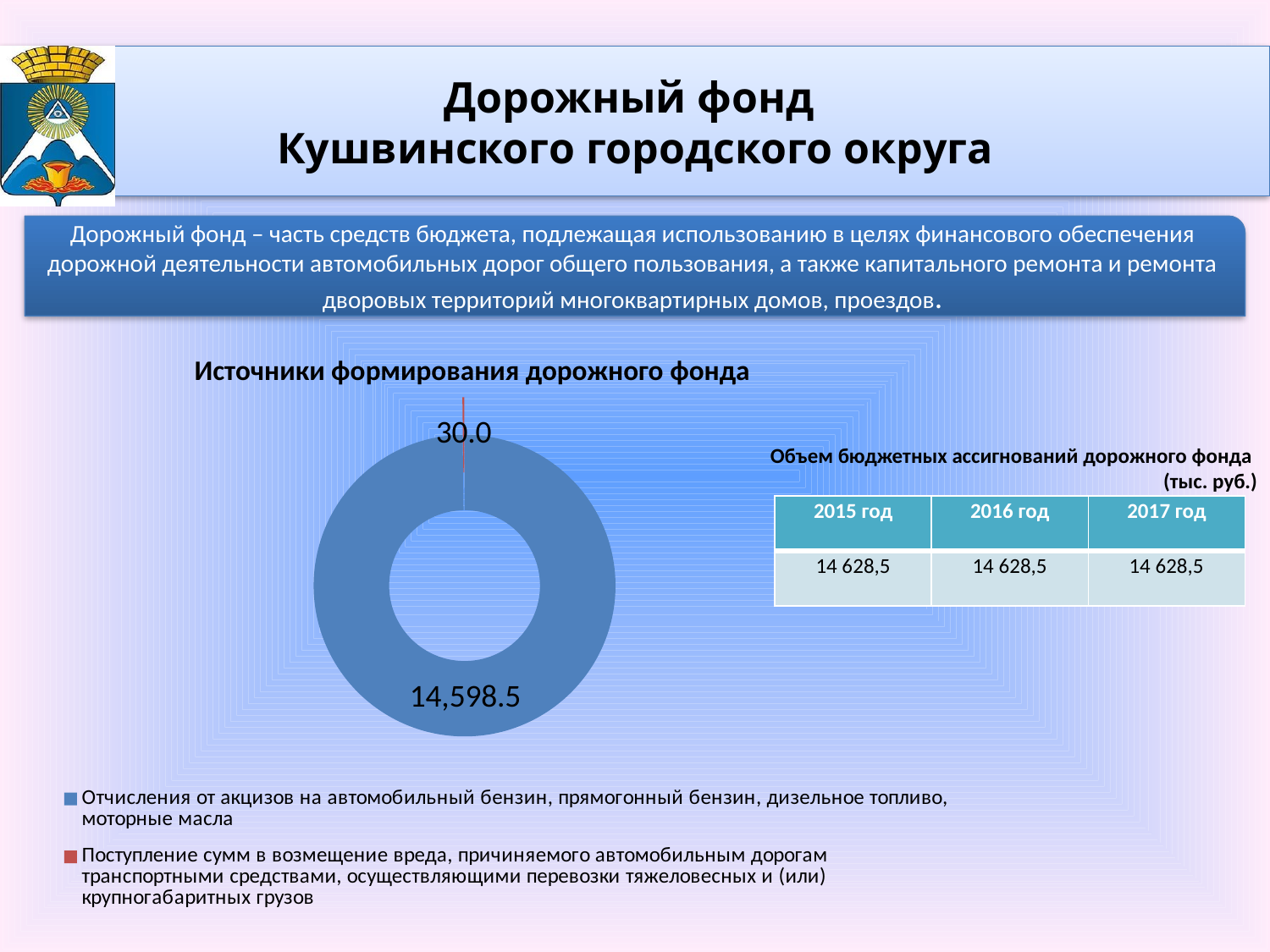
What is the difference between the two slice values in the doughnut chart (14,598.5 and 30.0)? 14,568.5 What kind of chart is shown under the title "Источники формирования дорожного фонда"? doughnut chart What is the value of the slice for "Отчисления от акцизов на автомобильный бензин, прямогонный бензин, дизельное топливо, моторные масла"? 14,598.5 What is the total of the two slice values shown in the doughnut chart? 14,628.5 What is the value of the slice for "Поступление сумм в возмещение вреда, причиняемого автомобильным дорогам транспортными средствами, осуществляющими перевозки тяжеловесных и (или) крупногабаритных грузов"? 30.0 Which is larger in the doughnut chart: the slice for excise deductions (акцизы) or the slice for damage compensation (возмещение вреда)? excise deductions (акцизы) Which source of the road fund has the largest slice in the doughnut chart? Отчисления от акцизов на автомобильный бензин, прямогонный бензин, дизельное топливо, моторные масла How many entries does the legend of the doughnut chart list? 2 What colour is the slice for "Отчисления от акцизов на автомобильный бензин, прямогонный бензин, дизельное топливо, моторные масла"? blue What is the title of the doughnut chart? Источники формирования дорожного фонда Which source of the road fund has the smallest slice in the doughnut chart? Поступление сумм в возмещение вреда, причиняемого автомобильным дорогам транспортными средствами, осуществляющими перевозки тяжеловесных и (или) крупногабаритных грузов How many slices does the doughnut chart have? 2